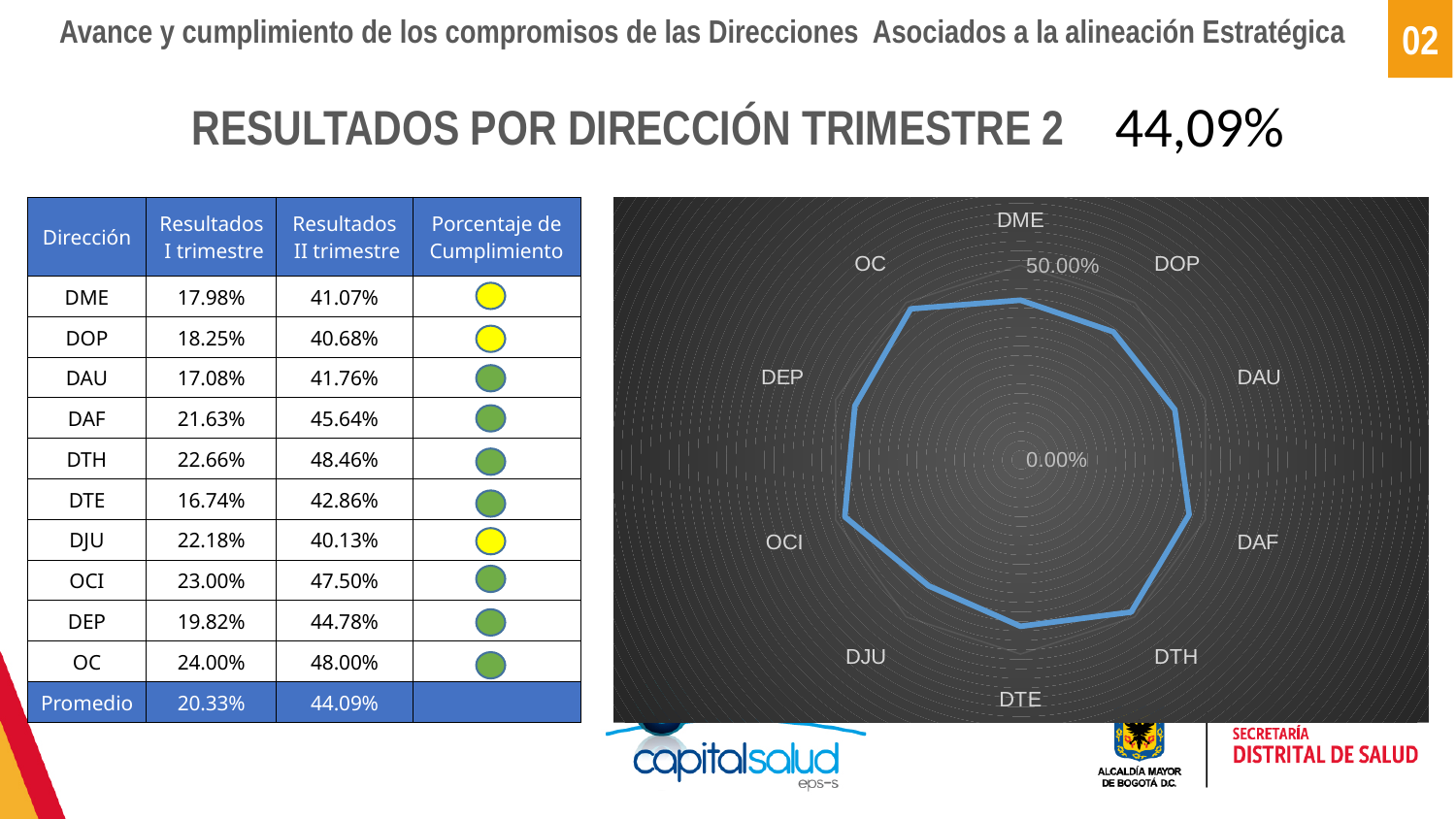
Which category label appears at the top of the radar chart? DME Is the value plotted for DME on the radar chart greater or less than 50.00%? less Is the value plotted for OC on the radar chart greater or less than 50.00%? less What kind of chart is shown on the right side of the slide? radar chart How many categories (direcciones) are plotted on the radar chart? 10 Is the value plotted for DJU on the radar chart greater or less than 0.00%? greater What is the highest axis value labelled on the radar chart? 50.00%